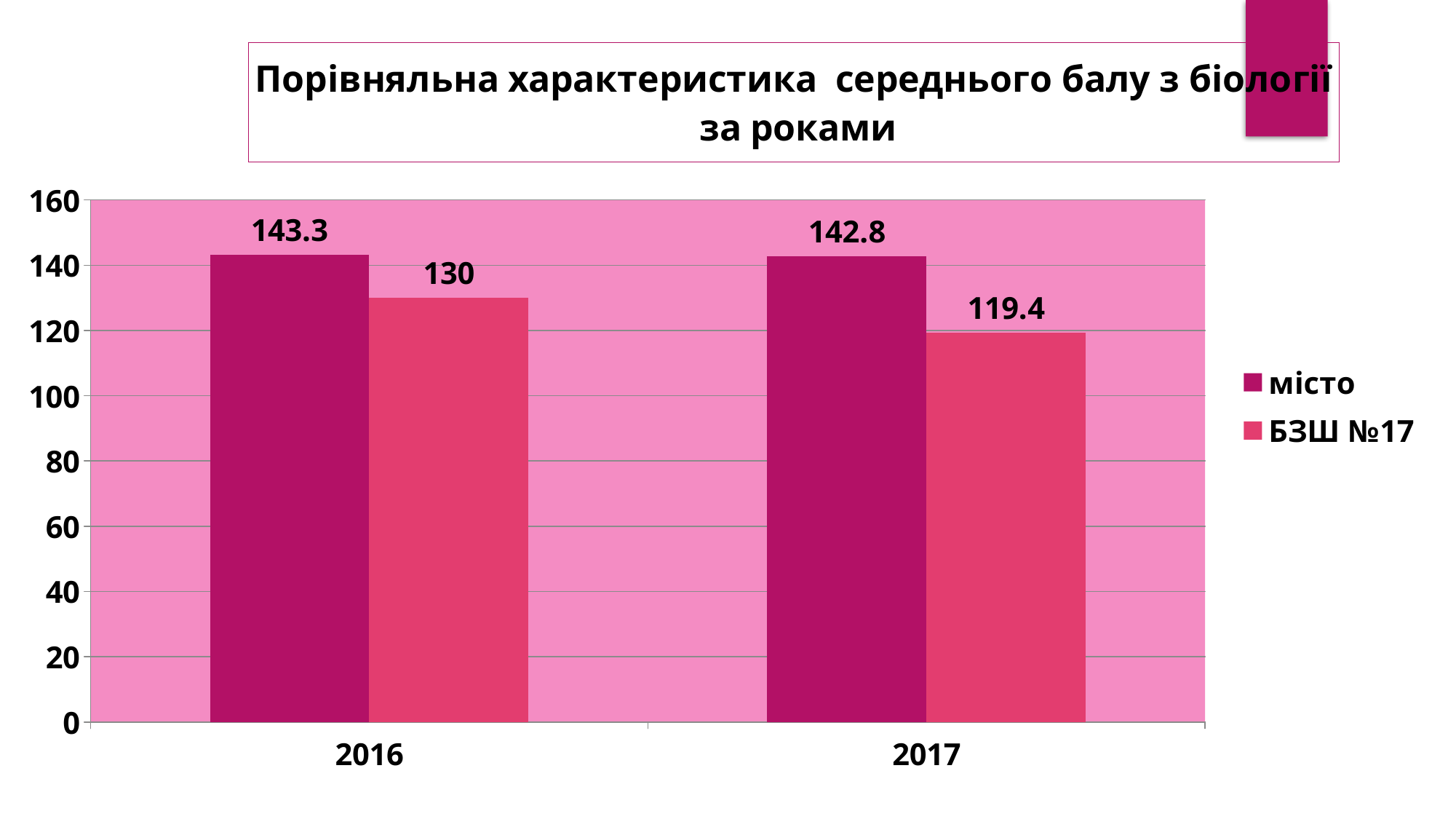
Which year has the lowest value for БЗШ №17? 2017 What is the value for БЗШ №17 in 2017? 119.4 How many series does the legend list? 2 What is the value for місто in 2016? 143.3 Which is larger in 2016: місто or БЗШ №17? місто What kind of chart is shown on the slide? bar chart What is the value for місто in 2017? 142.8 How many years are shown on the x axis? 2 What is the difference between місто and БЗШ №17 in 2017? 23.4 What is the value for БЗШ №17 in 2016? 130 Is the value for БЗШ №17 in 2017 greater or less than 120? less What is the difference between the БЗШ №17 values for 2016 and 2017? 10.6